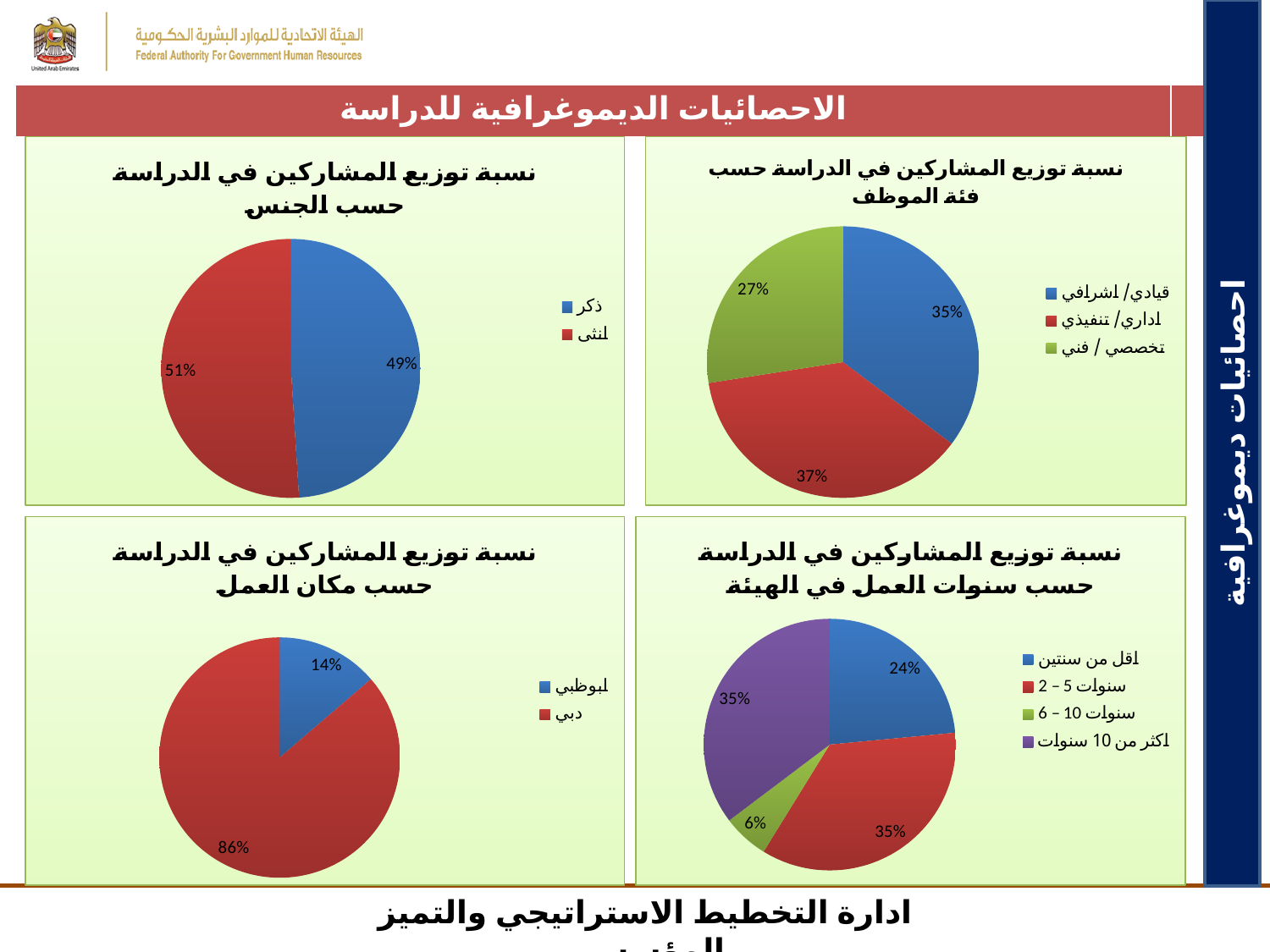
In the bottom-left pie chart (distribution by workplace), what percentage is shown for أبوظبي? 14% In the bottom-left pie chart (distribution by workplace), what is the difference between the shares for دبي and أبوظبي? 72% How many categories does the legend of the top-right pie chart (distribution by employee category) list? 3 In the bottom-right pie chart (distribution by years of work), which category has the smallest share? 6 - 10 سنوات (6%) In the top-right pie chart (distribution by employee category), what percentage is shown for تخصصي / فني? 27% In the top-left pie chart (distribution by gender), what is the difference between the female and male shares? 2% How many categories does the legend of the bottom-right pie chart (distribution by years of work) list? 4 In the top-left pie chart (distribution by gender), what percentage is shown for ذكر (male)? 49% What type of chart is used for all four charts on the slide? Pie chart In the bottom-right pie chart (distribution by years of work), what percentage is shown for أقل من سنتين? 24% In the top-right pie chart (distribution by employee category), which category has the largest share? إداري / تنفيذي (37%) In the top-left pie chart (distribution by gender), which category has the larger share? أنثى (51%)